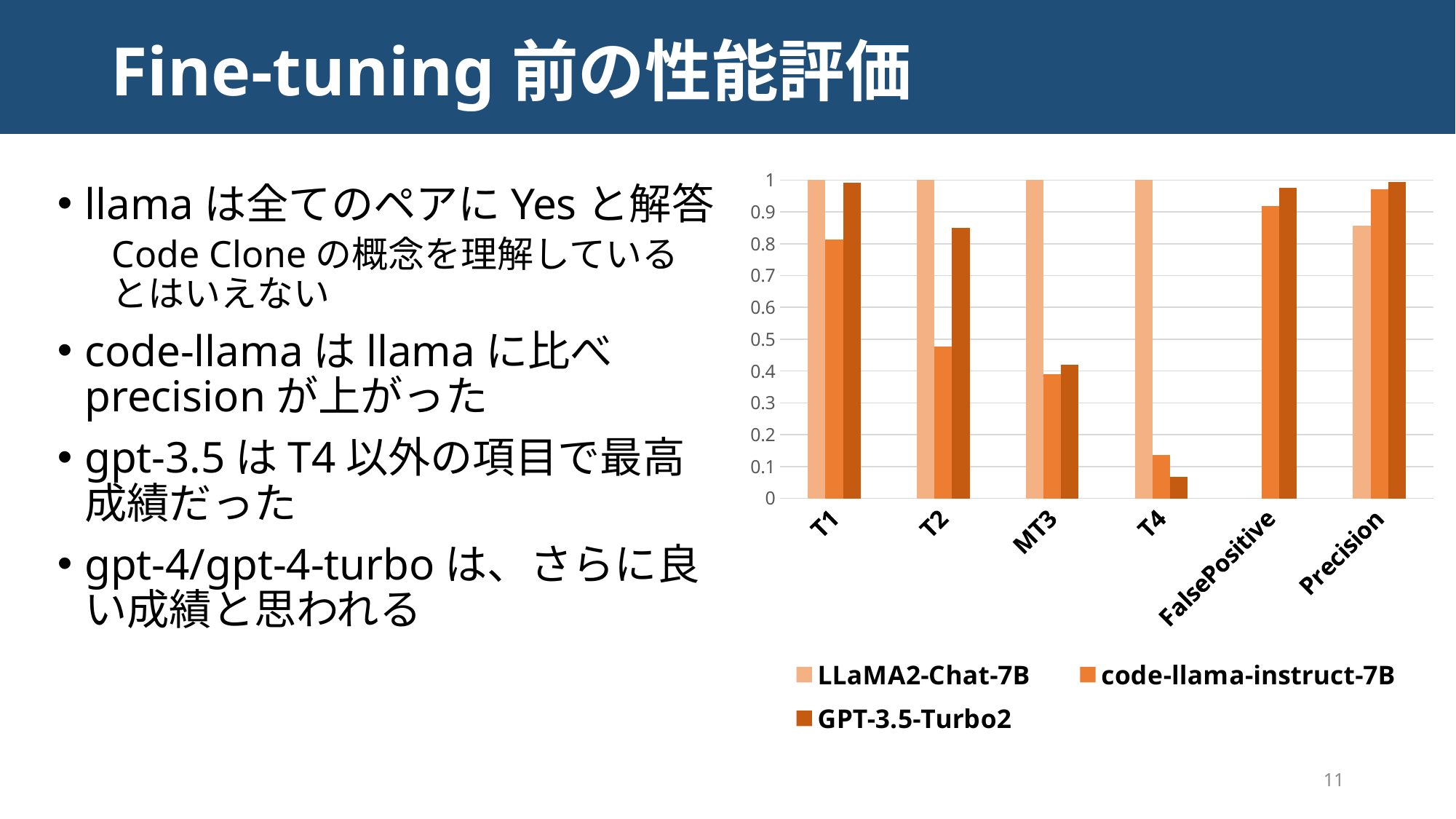
Do the values for code-llama-instruct-7B rise or fall from T1 to T4? fall Is the value for GPT-3.5-Turbo2 at FalsePositive greater or less than 0.9? greater Which is larger at T2: the value for code-llama-instruct-7B or the value for GPT-3.5-Turbo2? GPT-3.5-Turbo2 What is the value for LLaMA2-Chat-7B at T1? 1 Which series is listed first in the legend? LLaMA2-Chat-7B Is the value for GPT-3.5-Turbo2 at T2 greater or less than 0.8? greater How many categories are shown on the x axis? 6 Which category has the lowest value for GPT-3.5-Turbo2? T4 Is the value for code-llama-instruct-7B at T2 greater or less than 0.5? less How many series does the legend list? 3 What kind of chart is shown on the slide? bar chart